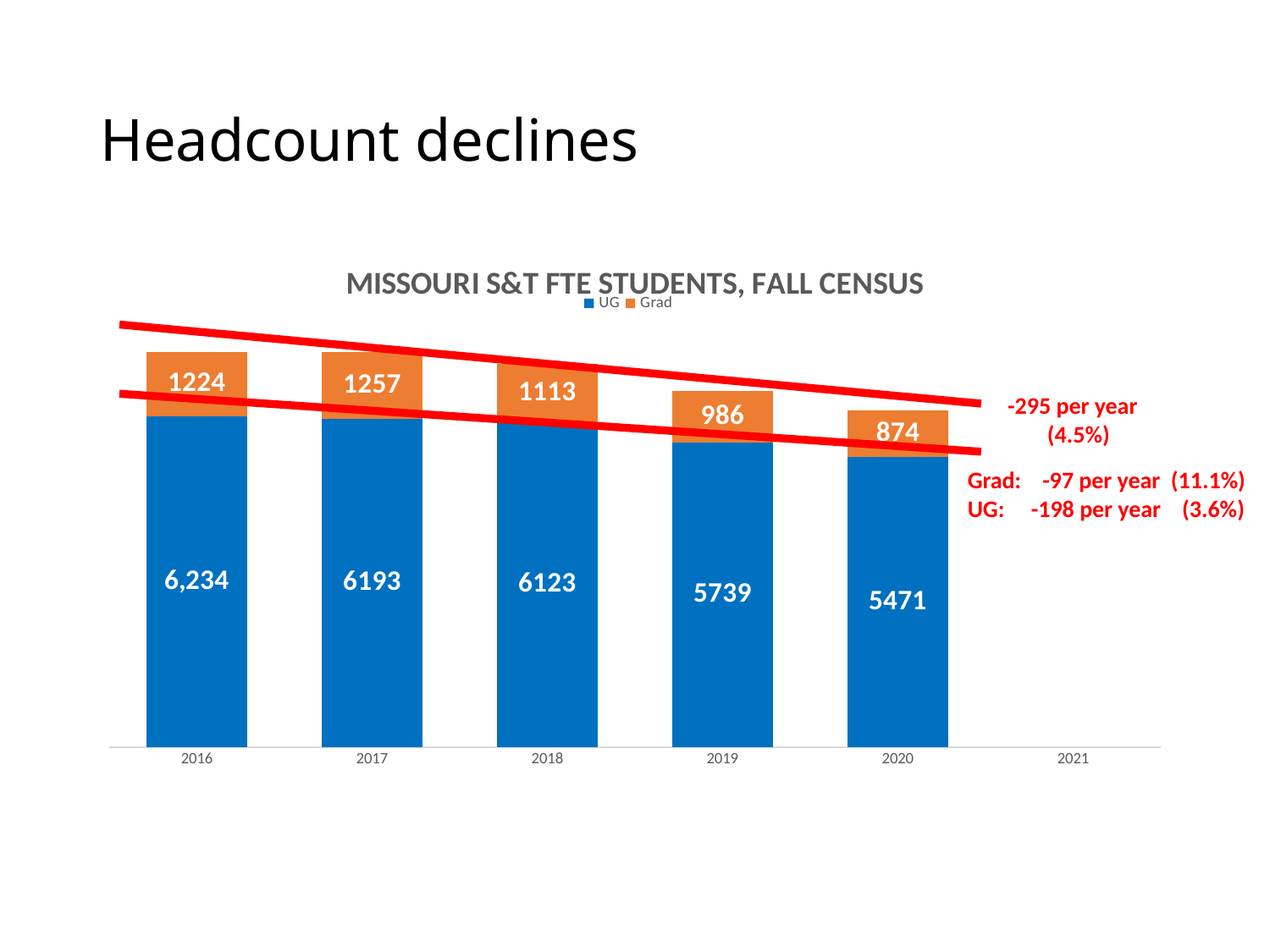
What is the UG value for 2016? 6,234 What is the difference between the UG values for 2016 and 2020? 763 Which is larger, the Grad value for 2016 or the Grad value for 2018? 2016 Do the UG values rise or fall from 2016 to 2020? Fall How many series does the legend list? 2 What is the UG value for 2018? 6123 How many years have bars plotted in the chart? 5 What kind of chart is shown on the slide? Stacked bar chart What is the Grad value for 2019? 986 Which year has the highest Grad value? 2017 What is the total of the stacked bar for 2020? 6345 Which year has the lowest UG value? 2020